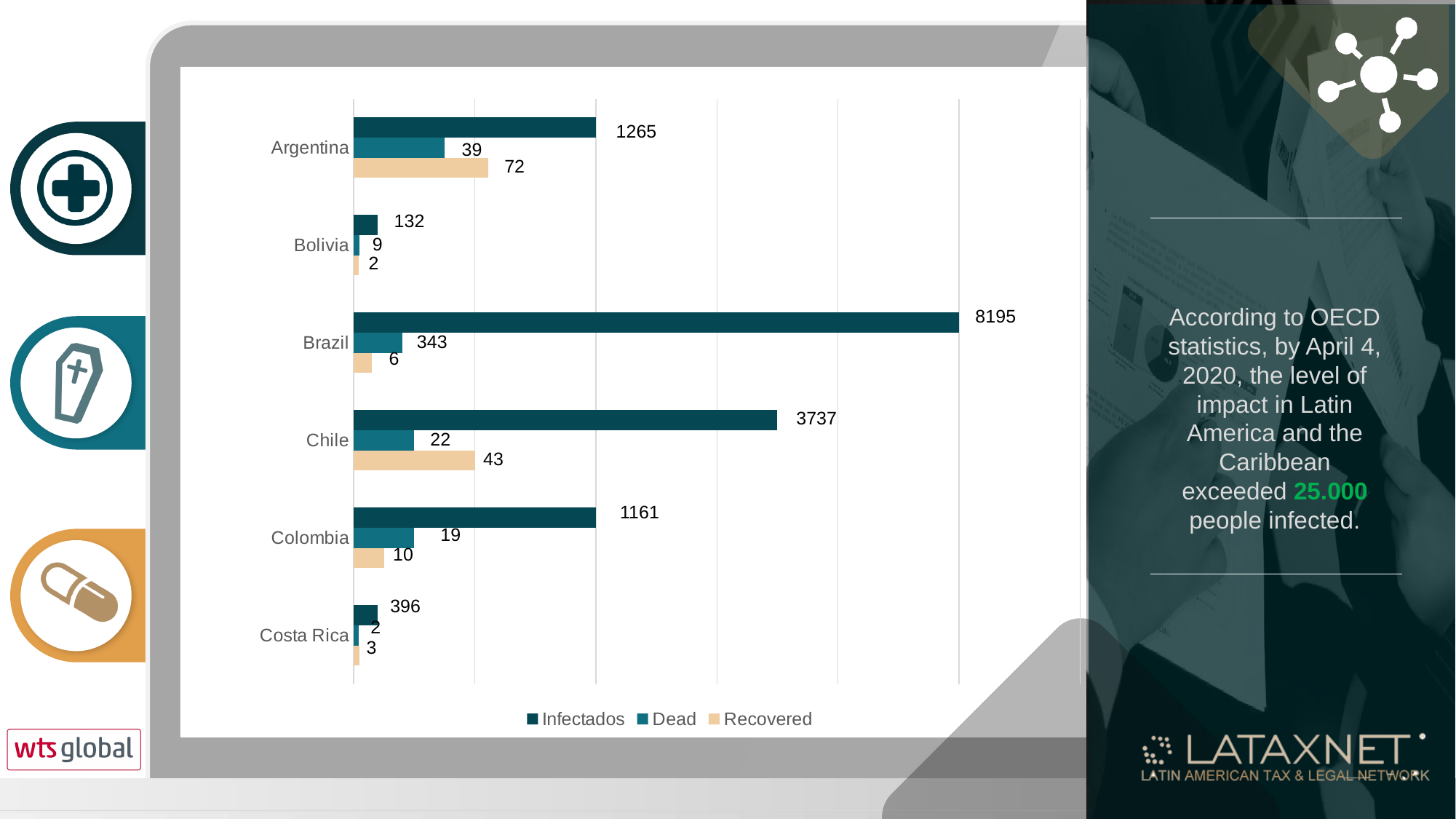
Which country has the highest Infectados value? Brazil Which country has the highest Dead value? Brazil Which is larger, the Recovered value for Argentina or the Recovered value for Chile? Argentina How many countries are shown on the chart? 6 What is the Infectados value for Brazil? 8195 What is the Recovered value for Chile? 43 Which country has the lowest Infectados value? Bolivia What is the difference between the Infectados values for Chile and Colombia? 2576 What are the three series listed in the legend? Infectados, Dead, Recovered What is the Dead value for Argentina? 39 How many series does the legend list? 3 What kind of chart is shown on the slide? Bar chart